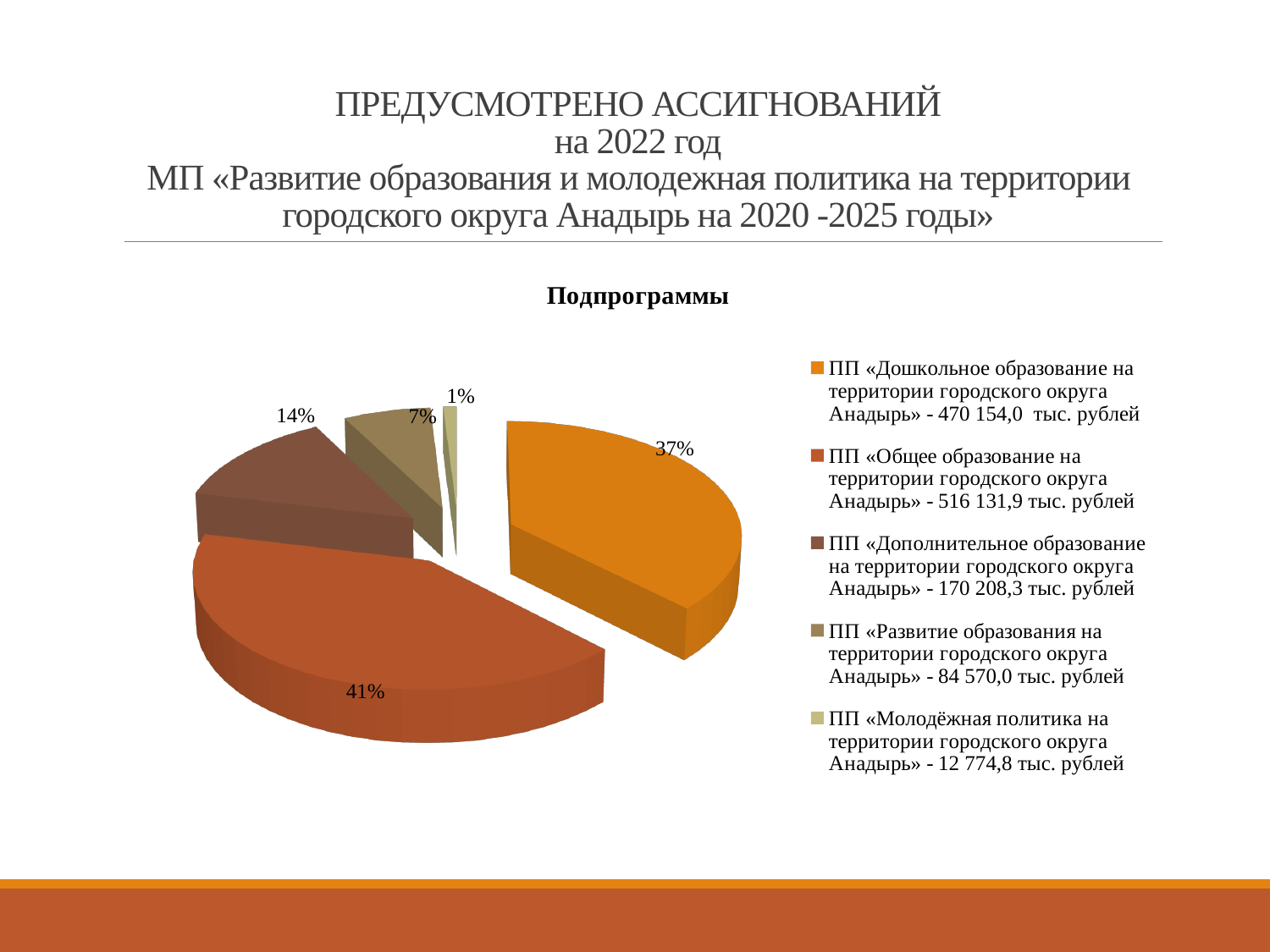
What is the difference in percentage points between the share for ПП «Общее образование» and the share for ПП «Дошкольное образование»? 4 percentage points Which subprogram has the largest share of the pie? ПП «Общее образование на территории городского округа Анадырь» What share of the pie does ПП «Общее образование на территории городского округа Анадырь» have? 41% What share of the pie does ПП «Молодёжная политика на территории городского округа Анадырь» have? 1% Which has the larger share: ПП «Дополнительное образование» or ПП «Развитие образования»? ПП «Дополнительное образование» Which subprogram has the smallest share of the pie? ПП «Молодёжная политика на территории городского округа Анадырь» What share of the pie does ПП «Дошкольное образование на территории городского округа Анадырь» have? 37% What kind of chart is shown on the slide? Pie chart According to the legend, what amount in thousand rubles is allocated to ПП «Развитие образования на территории городского округа Анадырь»? 84 570,0 тыс. рублей What is the title of the chart? Подпрограммы How many slices does the pie chart have? 5